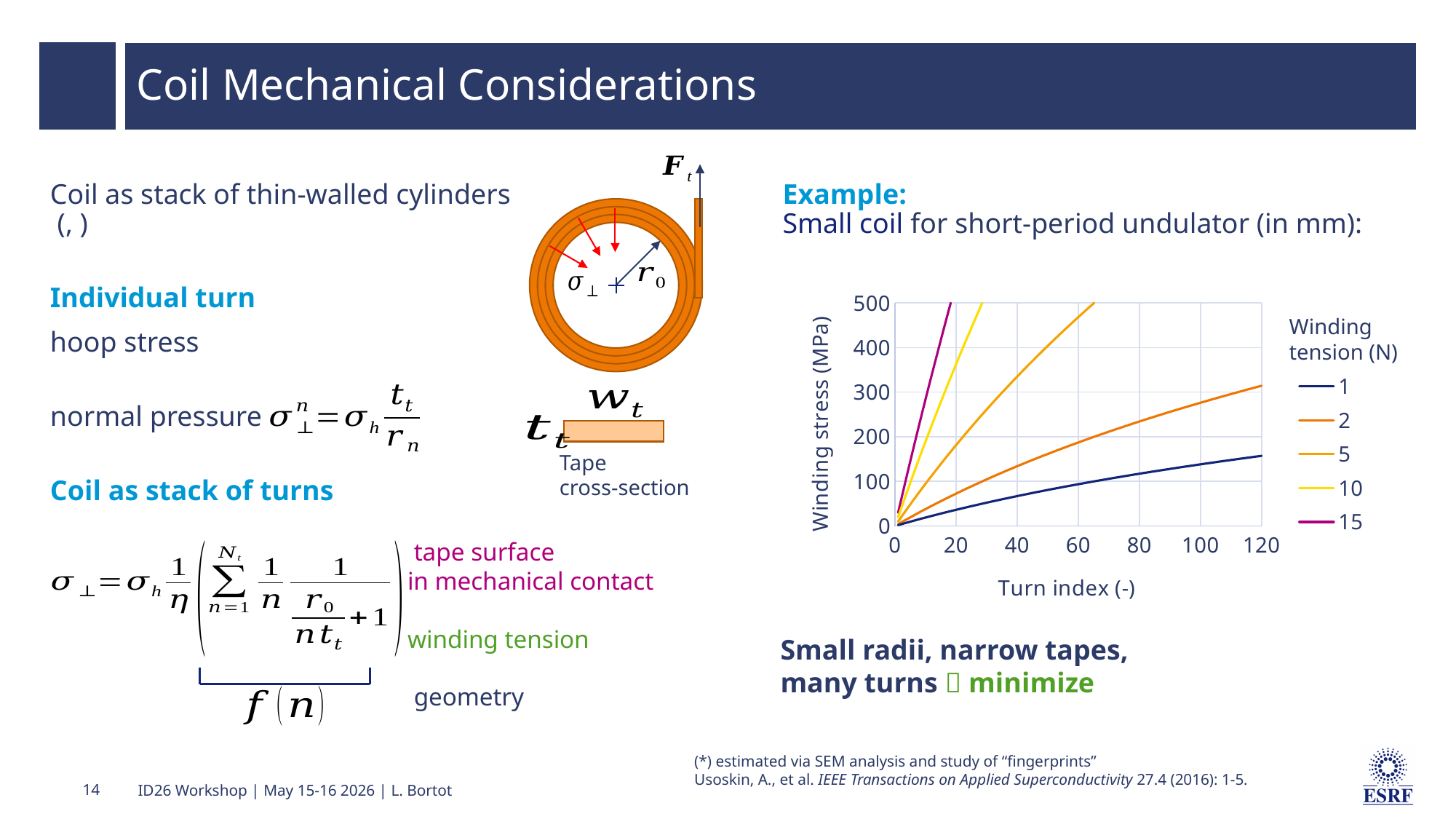
Which winding tension series reaches 500 MPa at the lowest turn index? 15 What is the title of the legend in the chart? Winding tension (N) Does the winding stress for a winding tension of 1 N rise or fall as the turn index increases? rise Is the winding stress for a winding tension of 2 N at turn index 120 greater or less than 200 MPa? greater What is the label of the x axis of the chart? Turn index (-) Which winding tension series has the lowest winding stress at turn index 120? 1 At turn index 120, which series has the higher winding stress: winding tension 1 N or winding tension 2 N? 2 N What kind of chart is shown on the slide? line chart What is the highest value shown on the y axis of the chart? 500 Is the winding stress for a winding tension of 1 N at turn index 120 greater or less than 200 MPa? less How many series does the legend of the chart list? 5 Is the winding stress for a winding tension of 5 N at turn index 60 greater or less than 400 MPa? greater